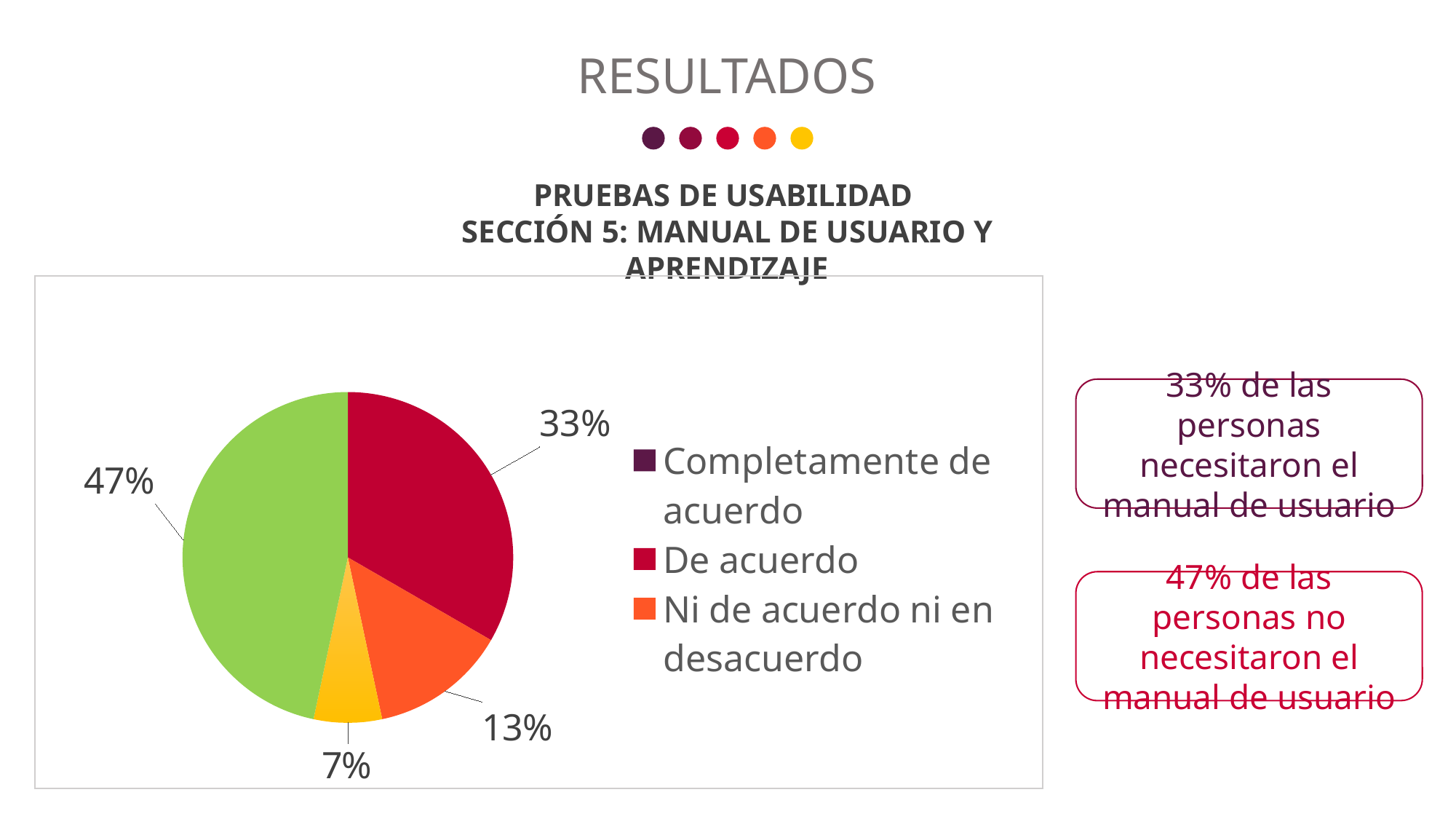
What percentage does the pie chart show for "Ni de acuerdo ni en desacuerdo"? 13% What is the smallest percentage labelled on the pie chart? 7% What colour is the "De acuerdo" slice in the pie chart? Red What is the combined share of the 33% and 47% slices? 80% By how many percentage points does "De acuerdo" exceed "Ni de acuerdo ni en desacuerdo"? 20 percentage points Which slice is larger, "De acuerdo" or "Ni de acuerdo ni en desacuerdo"? De acuerdo How many slices are visible in the pie chart? 4 What is the first entry listed in the chart legend? Completamente de acuerdo What percentage does the pie chart show for "De acuerdo"? 33% What kind of chart is shown on the slide? Pie chart How many entries does the chart legend list? 3 What is the largest percentage labelled on the pie chart? 47%